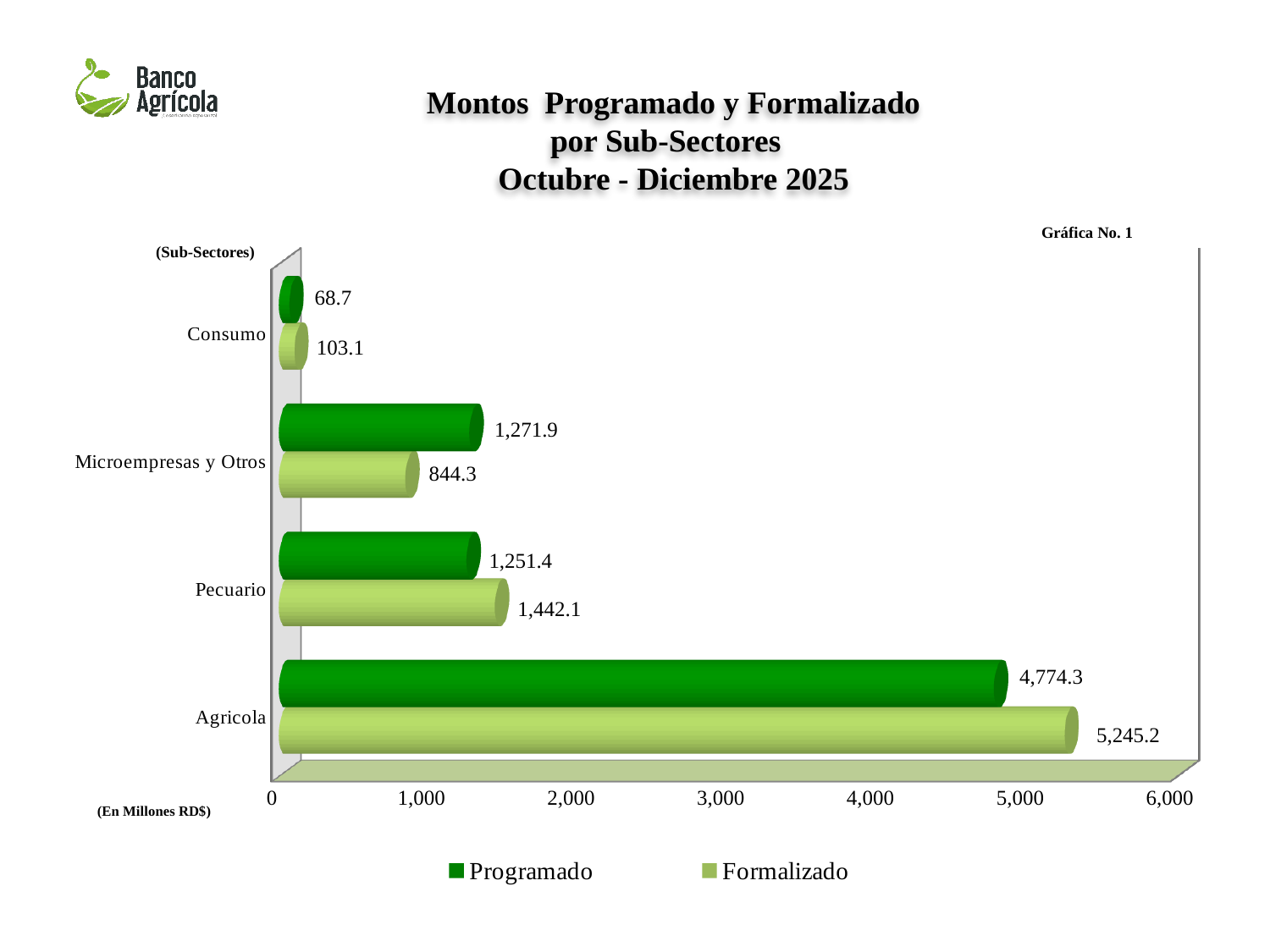
Which sub-sector has the highest Formalizado value? Agricola What is the Programado value for Microempresas y Otros? 1,271.9 What kind of chart is shown on the slide? Bar chart What is the difference between the Formalizado and Programado values for Agricola? 470.9 What is the difference between the Programado and Formalizado values for Microempresas y Otros? 427.6 How many sub-sectors are shown on the chart? 4 What is the Programado value for Agricola? 4,774.3 How many series does the legend list? 2 Which is larger for Pecuario, the Programado value or the Formalizado value? Formalizado What is the Formalizado value for Pecuario? 1,442.1 What is the Formalizado value for Consumo? 103.1 Which sub-sector has the lowest Programado value? Consumo